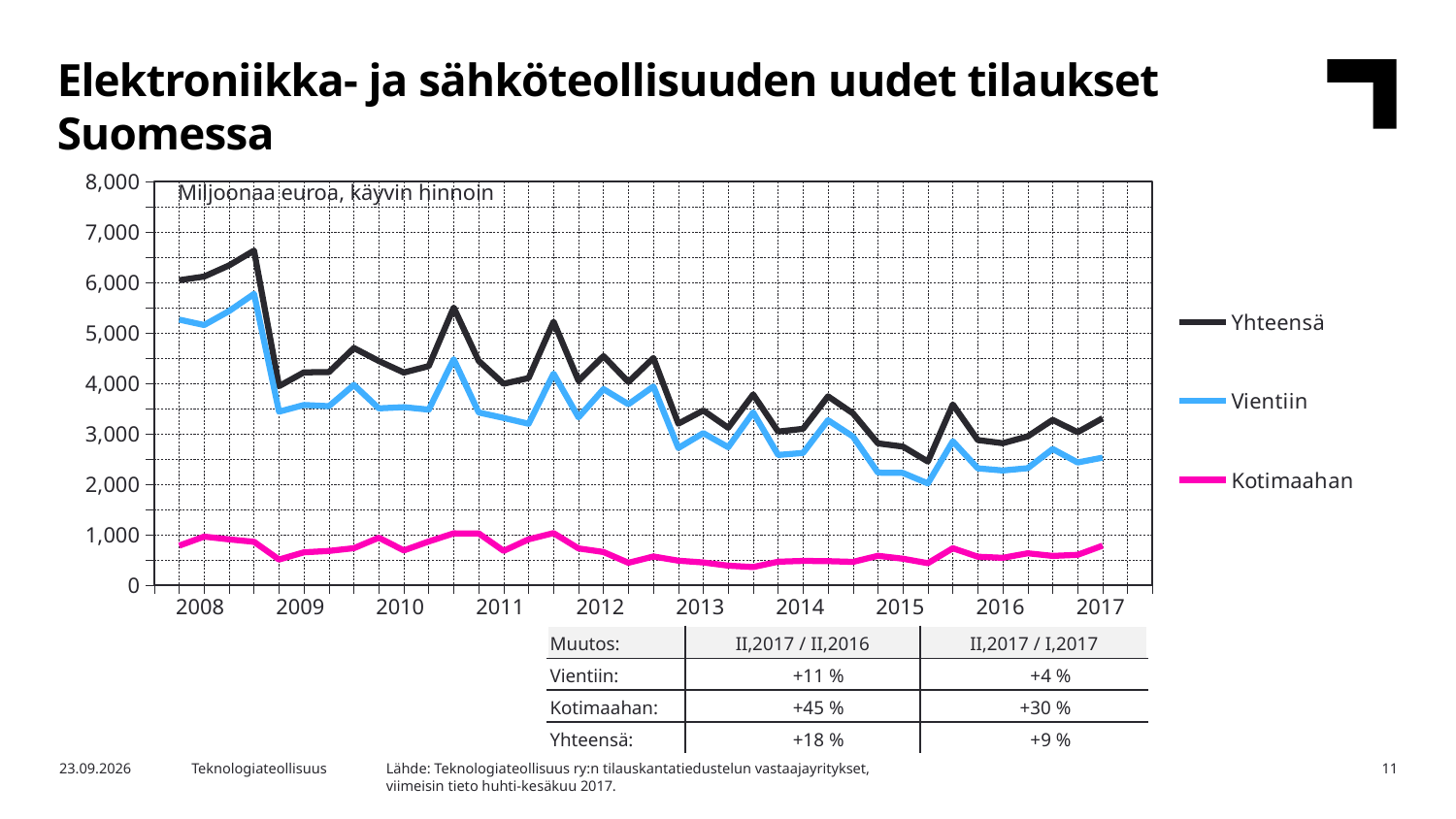
Is the value for Kotimaahan in 2012 greater or less than 2,000? less In 2010, which is larger, Vientiin or Kotimaahan? Vientiin How many year labels are shown on the x axis? 10 Is the value for Yhteensä at the start of 2008 greater or less than 5,000? greater Which series has the lowest values throughout the chart? Kotimaahan How many series does the legend list? 3 What unit is stated in the text at the top of the chart area? Miljoonaa euroa, käyvin hinnoin Does the Yhteensä line overall rise or fall from 2008 to 2017? fall Is the value for Vientiin in 2017 greater or less than 3,000? less What kind of chart is shown on the slide? line chart Which series has the highest values throughout the chart? Yhteensä What are the three series named in the legend? Yhteensä, Vientiin, Kotimaahan